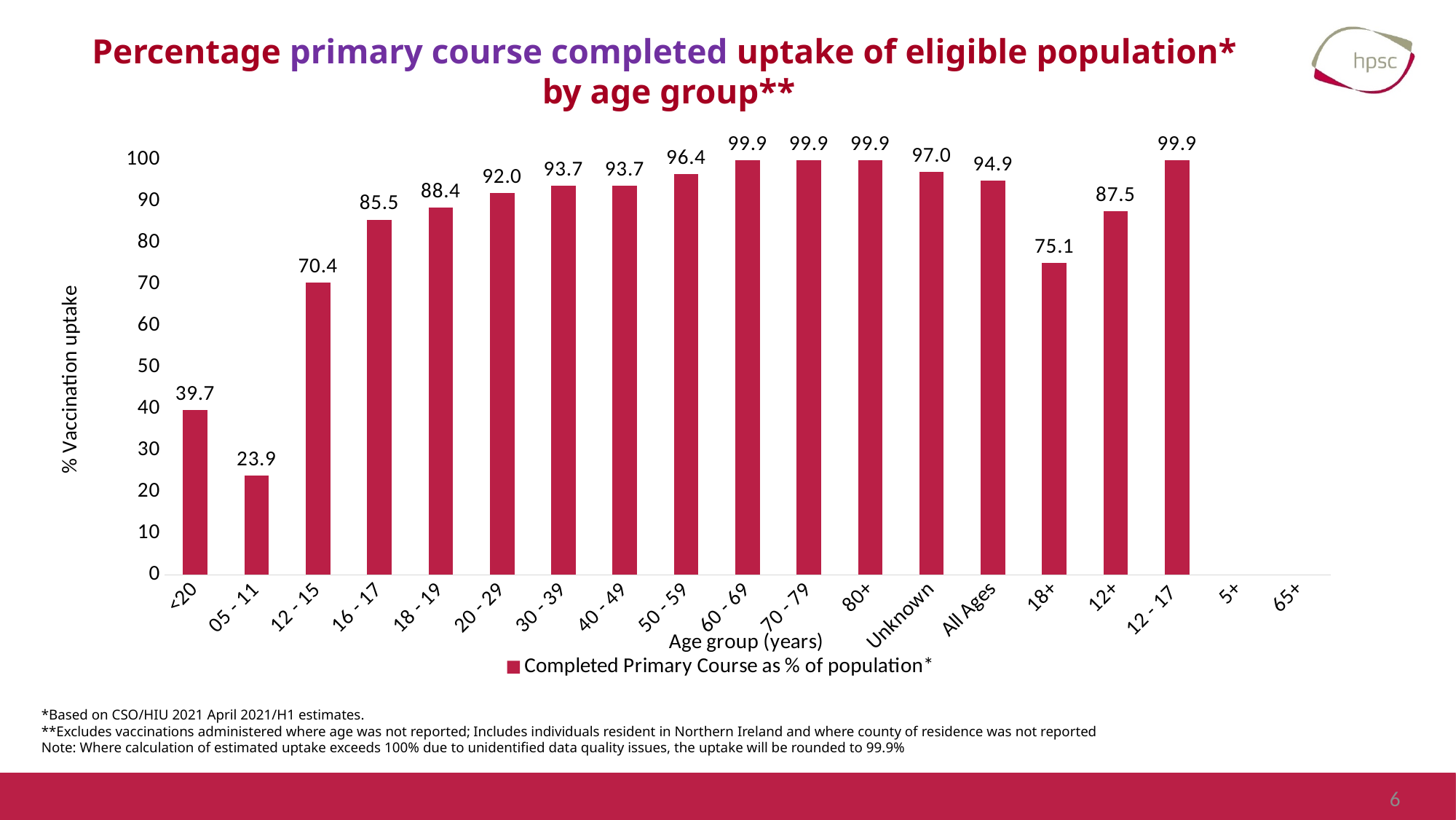
What is the value for the All Ages category? 94.9 How many series does the legend list? 1 What is the value for the 18+ age group? 75.1 Which has the larger value, 16 - 17 or 18 - 19? 18 - 19 Is the value for 12+ greater or less than 80? greater What is the value for the 50 - 59 age group? 96.4 What is the legend entry for the series shown? Completed Primary Course as % of population* What is the difference between the values for All Ages and 18+? 19.8 Which age group has the lowest vaccination uptake? 05 - 11 What is the difference between the values for 12 - 15 and <20? 30.7 What is the value for the 05 - 11 age group? 23.9 What kind of chart is shown on the slide? bar chart